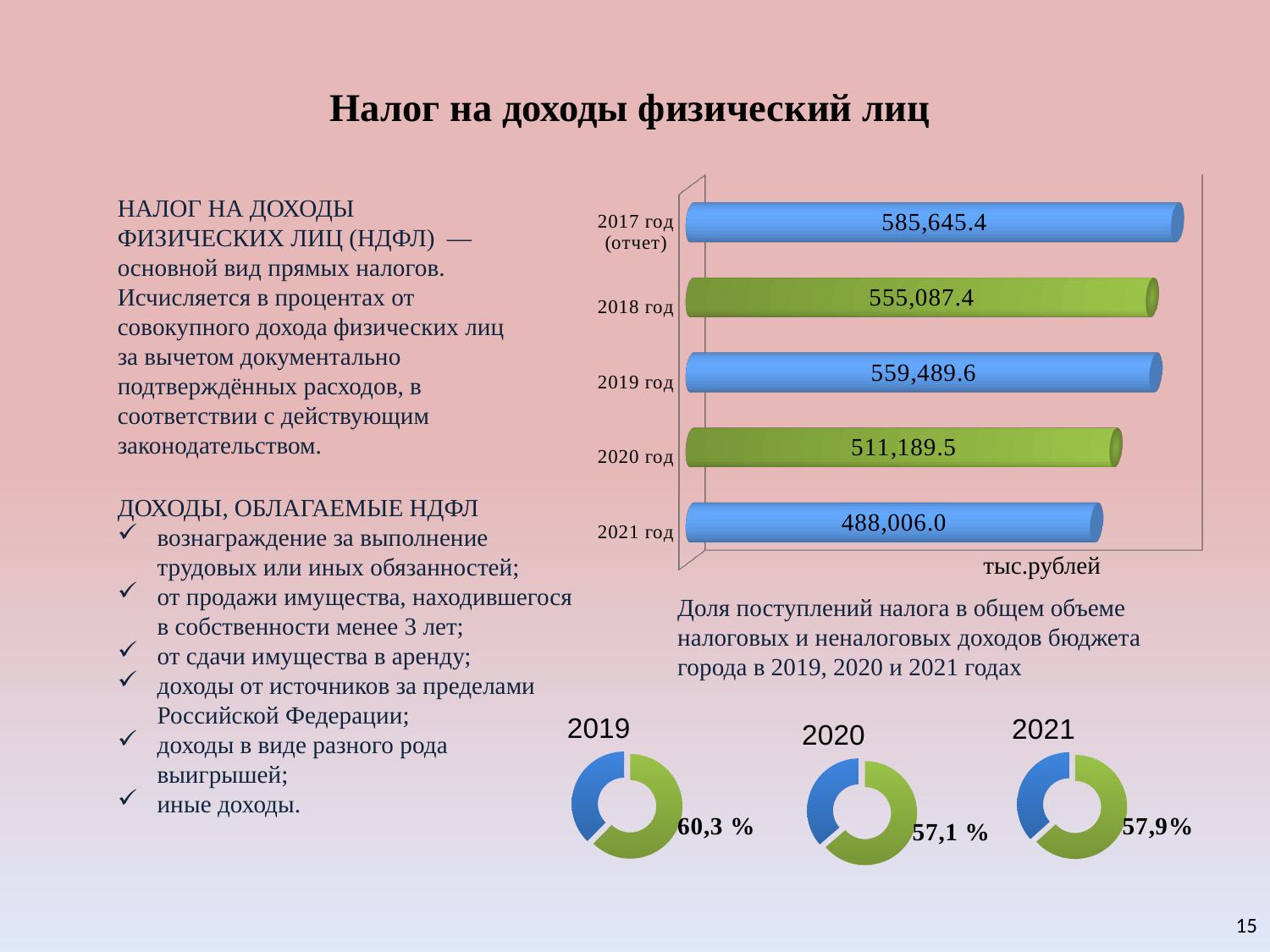
In the bar chart, what is the value for 2020 год? 511,189.5 What type of chart is the chart at the top right of the slide? Bar chart In the bar chart, what is the value for 2021 год? 488,006.0 In the bar chart, what is the difference between the values for 2017 год (отчет) and 2021 год? 97,639.4 In the bar chart, which is larger: the value for 2018 год or the value for 2019 год? 2019 год In the bar chart, which year has the lowest value? 2021 год How many bars does the bar chart show? 5 In the bar chart, do the values rise or fall from 2019 год to 2021 год? Fall In the bar chart, what is the difference between the values for 2019 год and 2018 год? 4,402.2 In the 2019 donut chart at the bottom of the slide, what share is labelled? 60,3 % In the bar chart, what is the value for 2018 год? 555,087.4 In the bar chart, which year has the highest value? 2017 год (отчет)